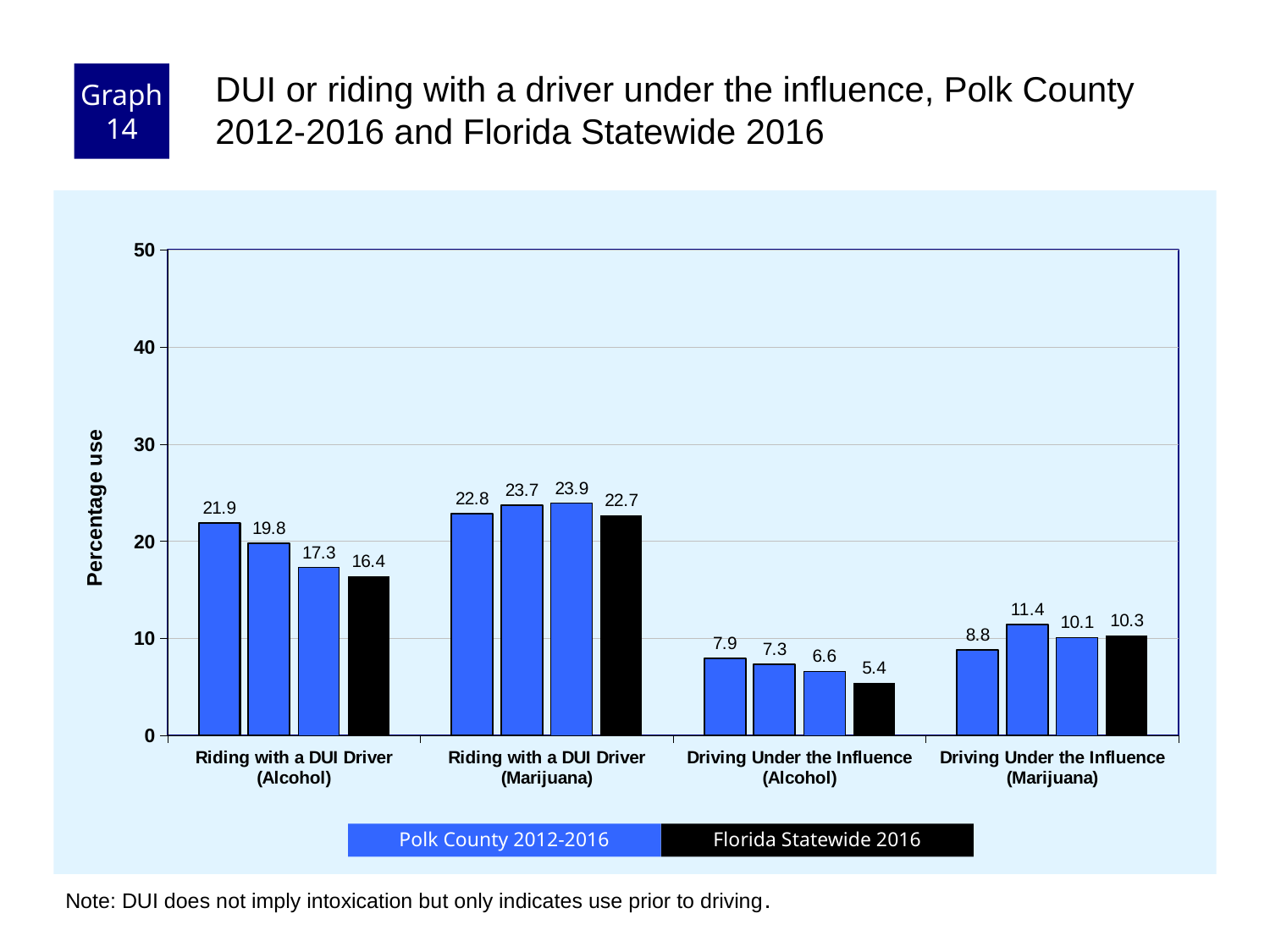
What is the Florida Statewide 2016 value for Driving Under the Influence (Alcohol)? 5.4 What is the value of the leftmost Polk County 2012-2016 bar for Riding with a DUI Driver (Marijuana)? 22.8 For Riding with a DUI Driver (Alcohol), what is the difference between the leftmost Polk County 2012-2016 bar and the Florida Statewide 2016 bar? 5.5 What kind of chart is shown on the slide? bar chart What is the Florida Statewide 2016 value for Riding with a DUI Driver (Alcohol)? 16.4 How many series does the legend list? 2 Do the Polk County 2012-2016 bars for Riding with a DUI Driver (Alcohol) rise or fall from left to right? fall Is the Florida Statewide 2016 value larger for Riding with a DUI Driver (Marijuana) or for Riding with a DUI Driver (Alcohol)? Riding with a DUI Driver (Marijuana) How many categories are shown on the x axis? 4 Is the Florida Statewide 2016 value for Riding with a DUI Driver (Marijuana) greater or less than 20? greater Which category has the tallest bar in the chart? Riding with a DUI Driver (Marijuana) What is the lowest value shown in the chart? 5.4